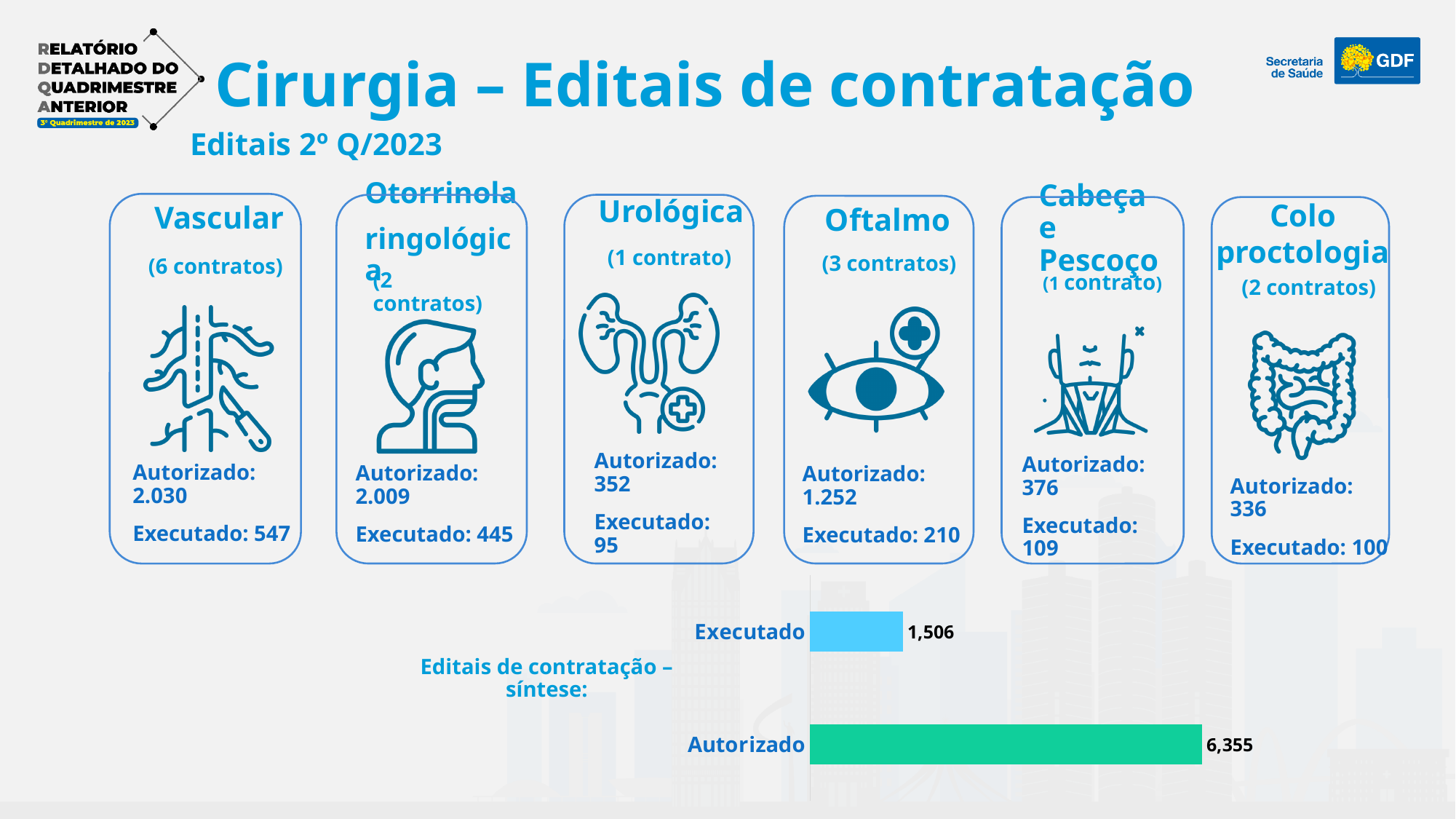
Which category has the highest value in the chart? Autorizado What colour is the Autorizado bar in the chart? Green Which category has the lowest value in the chart? Executado Which is larger in the chart, Executado or Autorizado? Autorizado What is the value of the Executado bar in the chart? 1,506 What is the title of the chart at the bottom of the slide? Editais de contratação – síntese: What is the difference between the Autorizado and Executado values in the chart? 4,849 What kind of chart is shown at the bottom of the slide? Bar chart What is the value of the Autorizado bar in the chart? 6,355 How many bars are plotted in the chart? 2